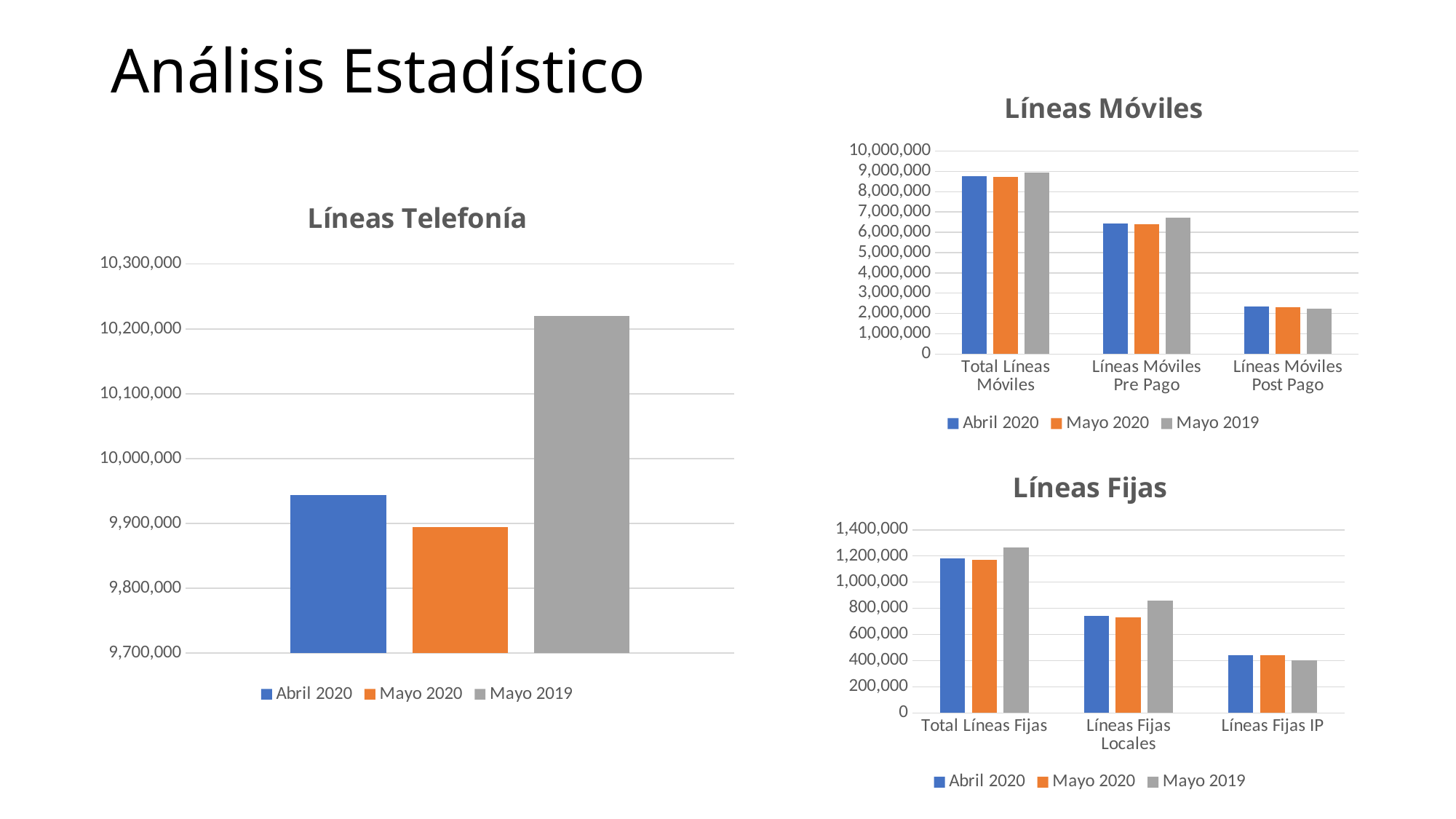
In the Líneas Telefonía chart, which series has the lowest value? Mayo 2020 In the Líneas Fijas chart, which is larger for Líneas Fijas Locales: Abril 2020 or Mayo 2019? Mayo 2019 In the Líneas Móviles chart, is the Abril 2020 value for Total Líneas Móviles greater or less than 8,000,000? greater In the Líneas Telefonía chart, is the value for Mayo 2019 greater or less than 10,100,000? greater In the Líneas Móviles chart, how many categories are shown on the x axis? 3 In the Líneas Telefonía chart, which series has the highest value? Mayo 2019 In the Líneas Móviles chart, how many series does the legend list? 3 In the Líneas Telefonía chart, is the value for Abril 2020 greater or less than 10,000,000? less In the Líneas Fijas chart, what colour represents Mayo 2020? Orange What kind of chart is the Líneas Fijas chart? Bar chart In the Líneas Móviles chart, which series has the highest value for Líneas Móviles Pre Pago? Mayo 2019